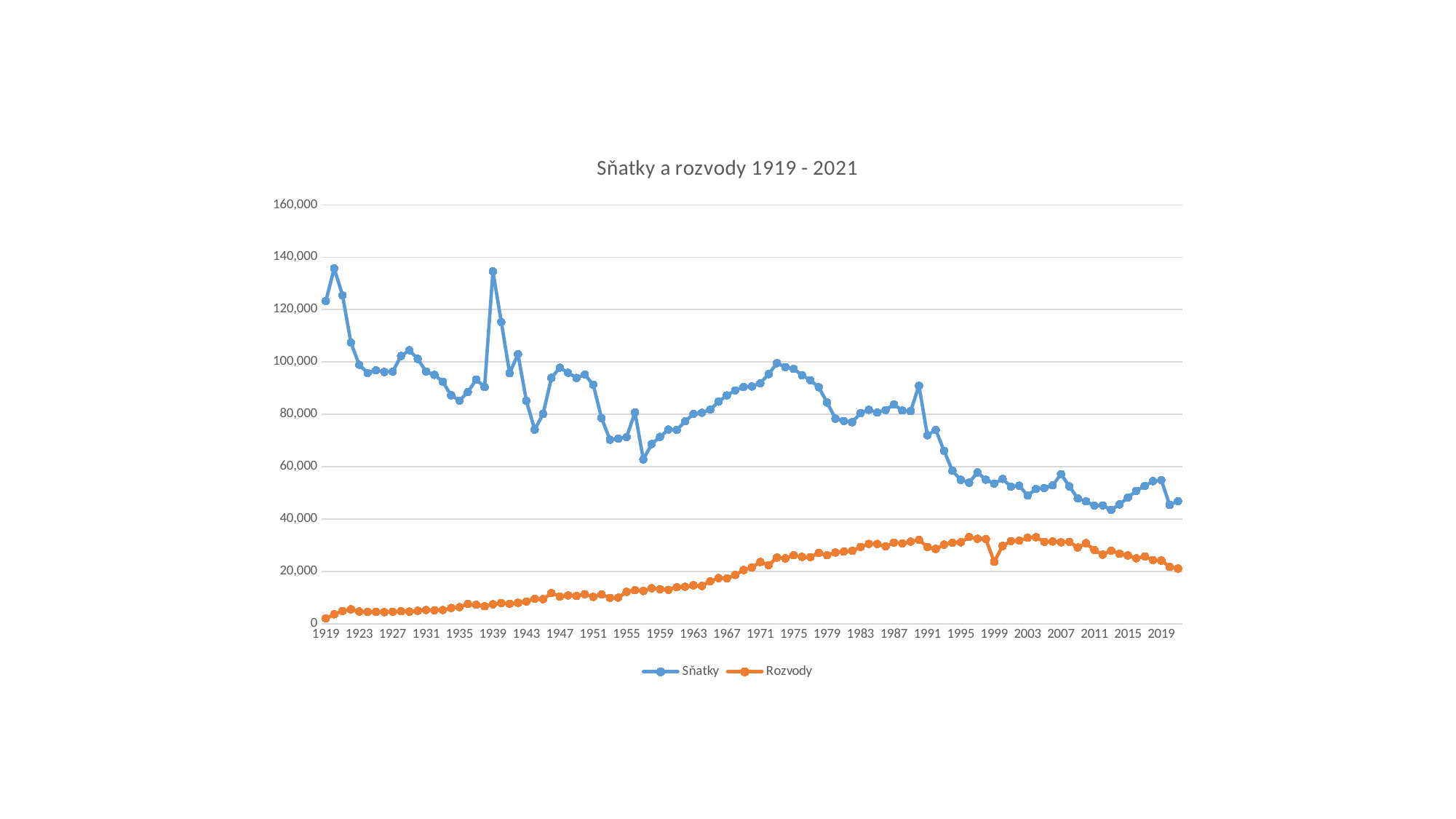
Which series has the higher value in 1991, Sňatky or Rozvody? Sňatky How many series does the legend list? 2 Is the value for Sňatky in 1939 greater or less than 120,000? greater Is the value for Rozvody in 1919 greater or less than 20,000? less What kind of chart is shown on the slide? line chart Is the value for Rozvody in 2003 greater or less than 20,000? greater What is the title of the chart? Sňatky a rozvody 1919 - 2021 Which colour is used for the Rozvody series? orange Do the Rozvody values generally rise or fall from 1919 to 2003? rise Which is larger, the Sňatky value in 1939 or the Sňatky value in 1943? 1939